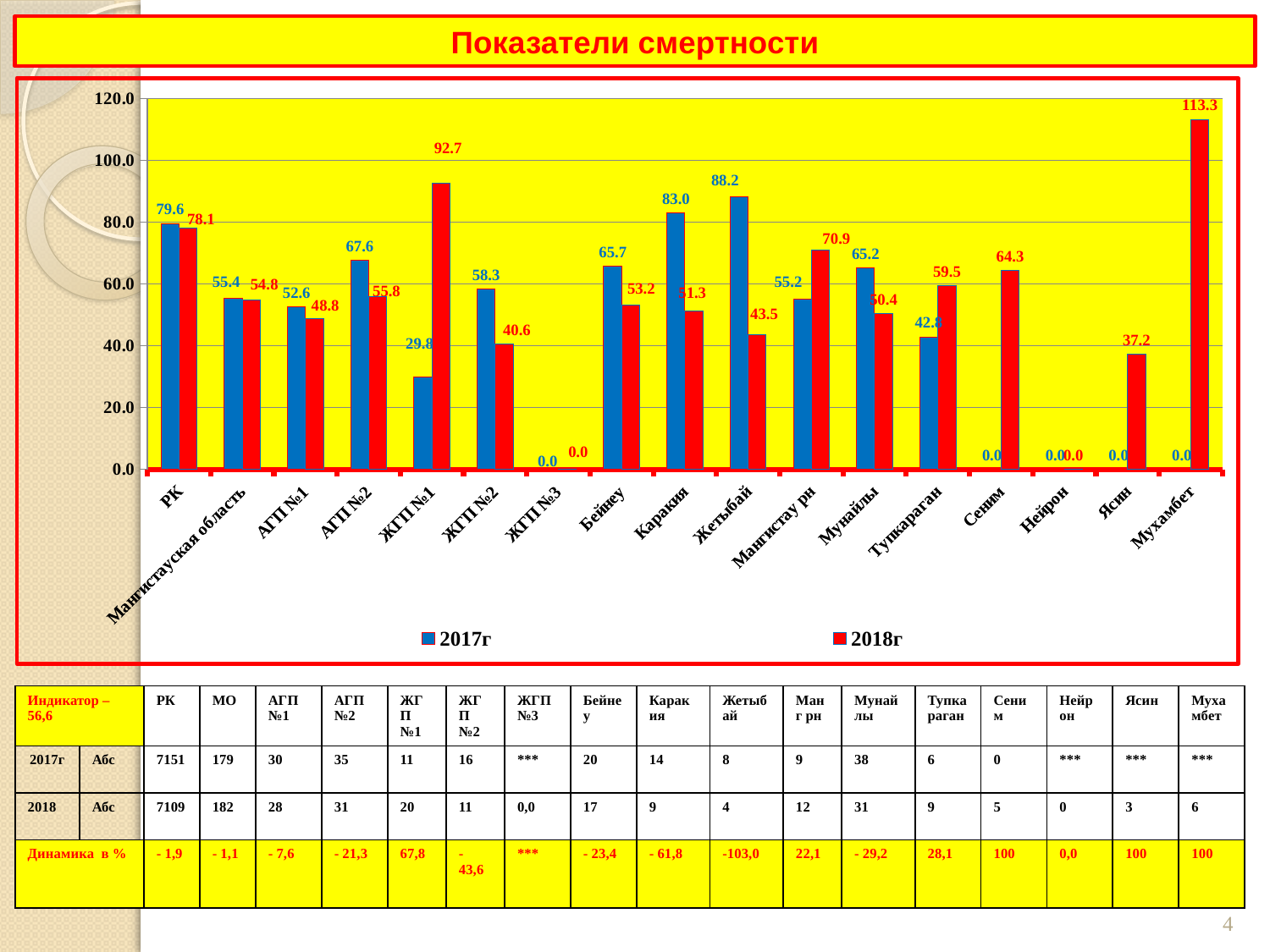
What is the value for Сеним in the 2018г series? 64.3 What type of chart is shown on the slide? bar chart Is the 2018г value for Ясин greater or less than 40.0? less Which category has the highest value in the 2017г series? Жетыбай What is the difference between the 2018г and 2017г values for ЖГП №1? 62.9 For Мангистау рн, which series has the larger value, 2017г or 2018г? 2018г What is the value for Жетыбай in the 2017г series? 88.2 Which category has the highest value in the 2018г series? Мухамбет What is the value for РК in the 2017г series? 79.6 Which colour represents the 2018г series in the chart? red How many series does the chart legend list? 2 What is the value for ЖГП №1 in the 2018г series? 92.7